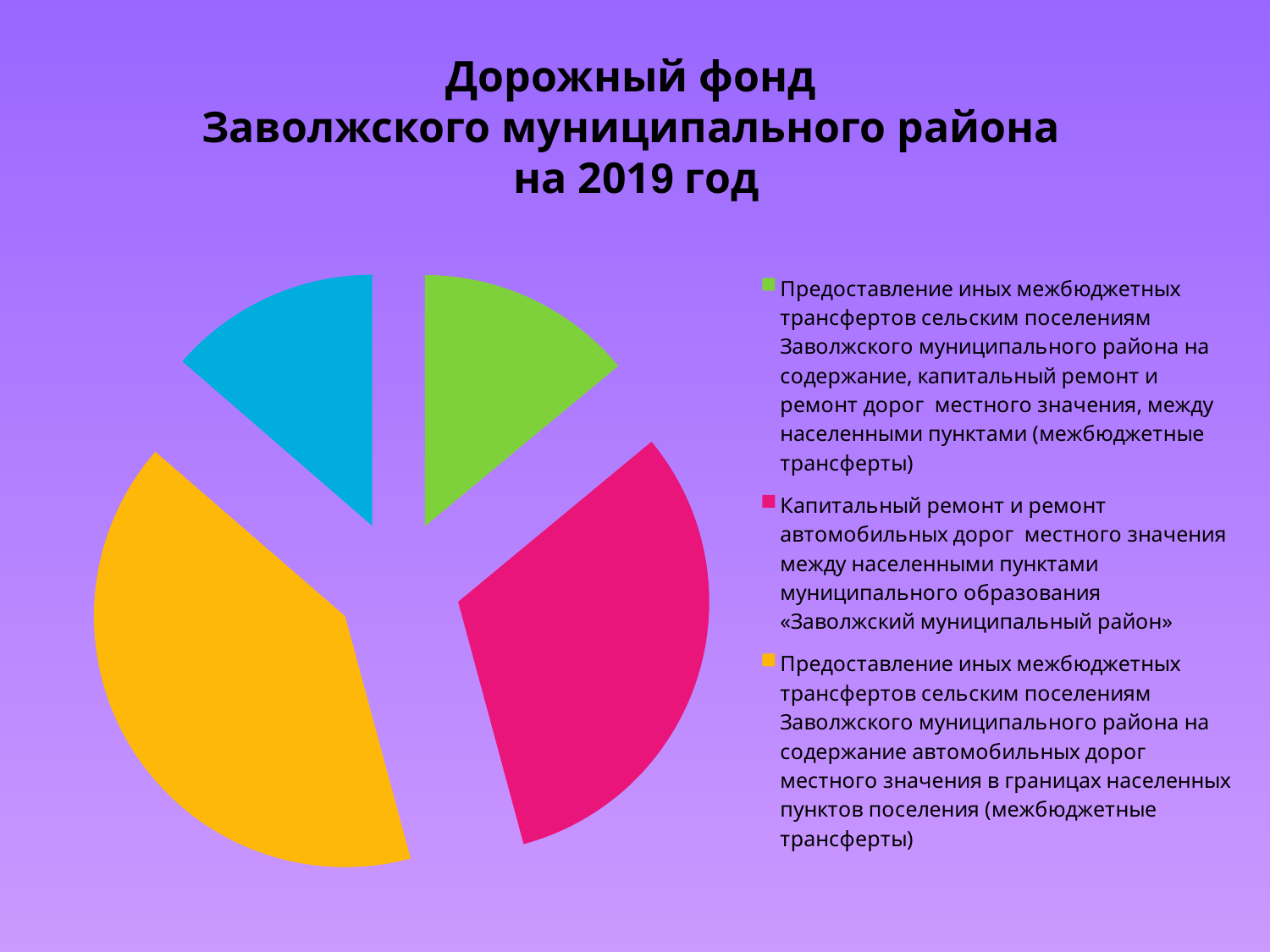
Which is larger: the yellow slice or the green slice of the pie chart? the yellow slice How many slices does the pie chart have? 4 What kind of chart is shown on the slide? pie chart Which is larger: the slice for «Предоставление иных межбюджетных трансфертов ... на содержание автомобильных дорог местного значения в границах населенных пунктов поселения (межбюджетные трансферты)» or the slice for «Предоставление иных межбюджетных трансфертов ... на содержание, капитальный ремонт и ремонт дорог местного значения, между населенными пунктами (межбюджетные трансферты)»? Предоставление иных межбюджетных трансфертов ... на содержание автомобильных дорог местного значения в границах населенных пунктов поселения (межбюджетные трансферты) How many entries does the legend of the pie chart list? 3 What is the title of the slide with the pie chart? Дорожный фонд Заволжского муниципального района на 2019 год Which is larger: the pink slice or the blue slice of the pie chart? the pink slice What colour is the slice for «Капитальный ремонт и ремонт автомобильных дорог местного значения между населенными пунктами муниципального образования «Заволжский муниципальный район»»? pink